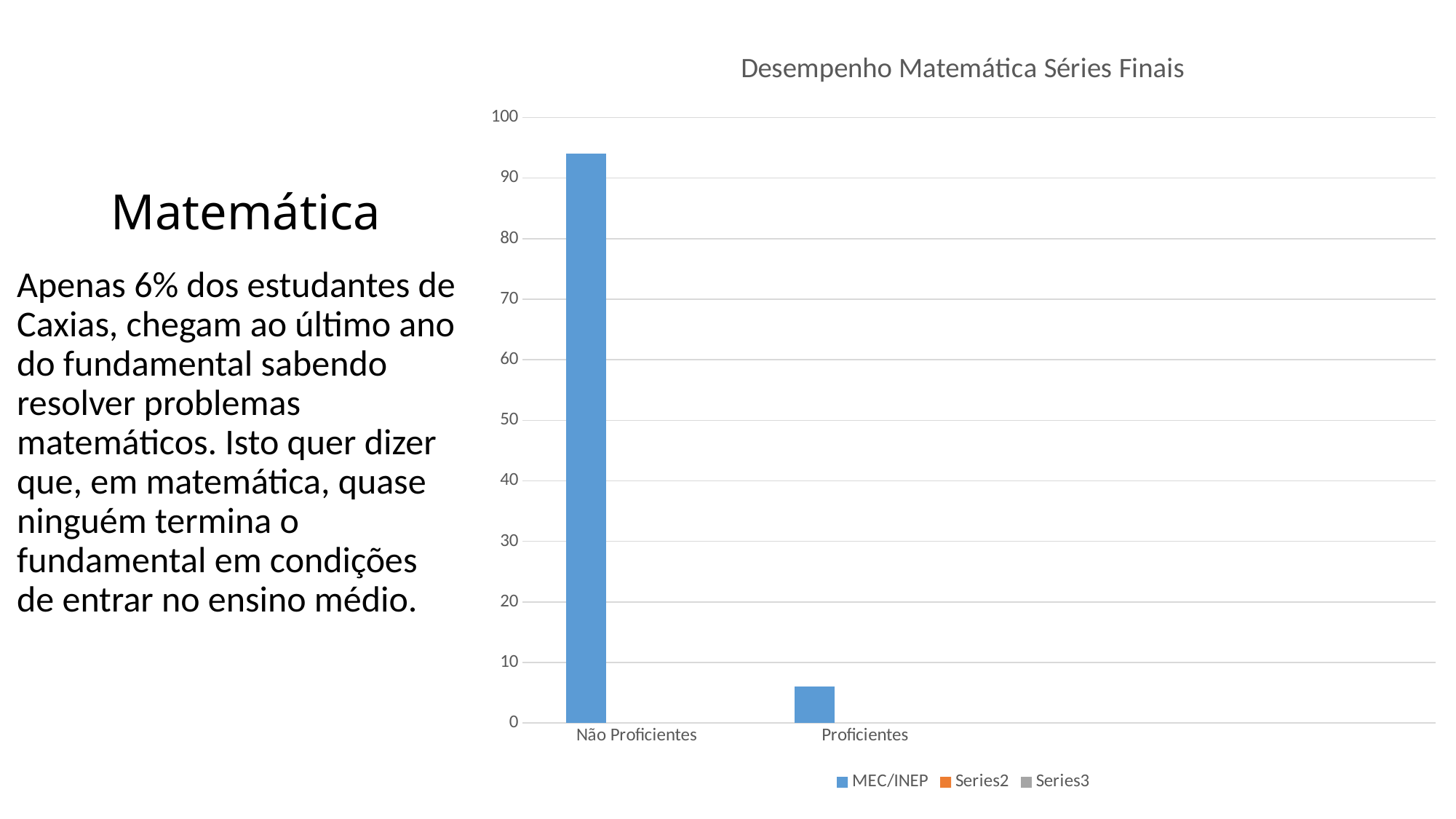
Which category has the lowest bar in the chart? Proficientes How many series does the chart legend list? 3 Is the value for Proficientes greater or less than 10? less Is the value for Não Proficientes greater or less than 90? greater Which is larger, the bar for Não Proficientes or the bar for Proficientes? Não Proficientes What is the title of the chart? Desempenho Matemática Séries Finais Is the value for Não Proficientes greater or less than 100? less What type of chart is shown on the slide? bar chart Do the bar values rise or fall from left to right along the x axis? fall What is the name of the first series listed in the chart legend? MEC/INEP Which category has the highest bar in the chart? Não Proficientes How many categories are shown on the x axis of the chart? 2